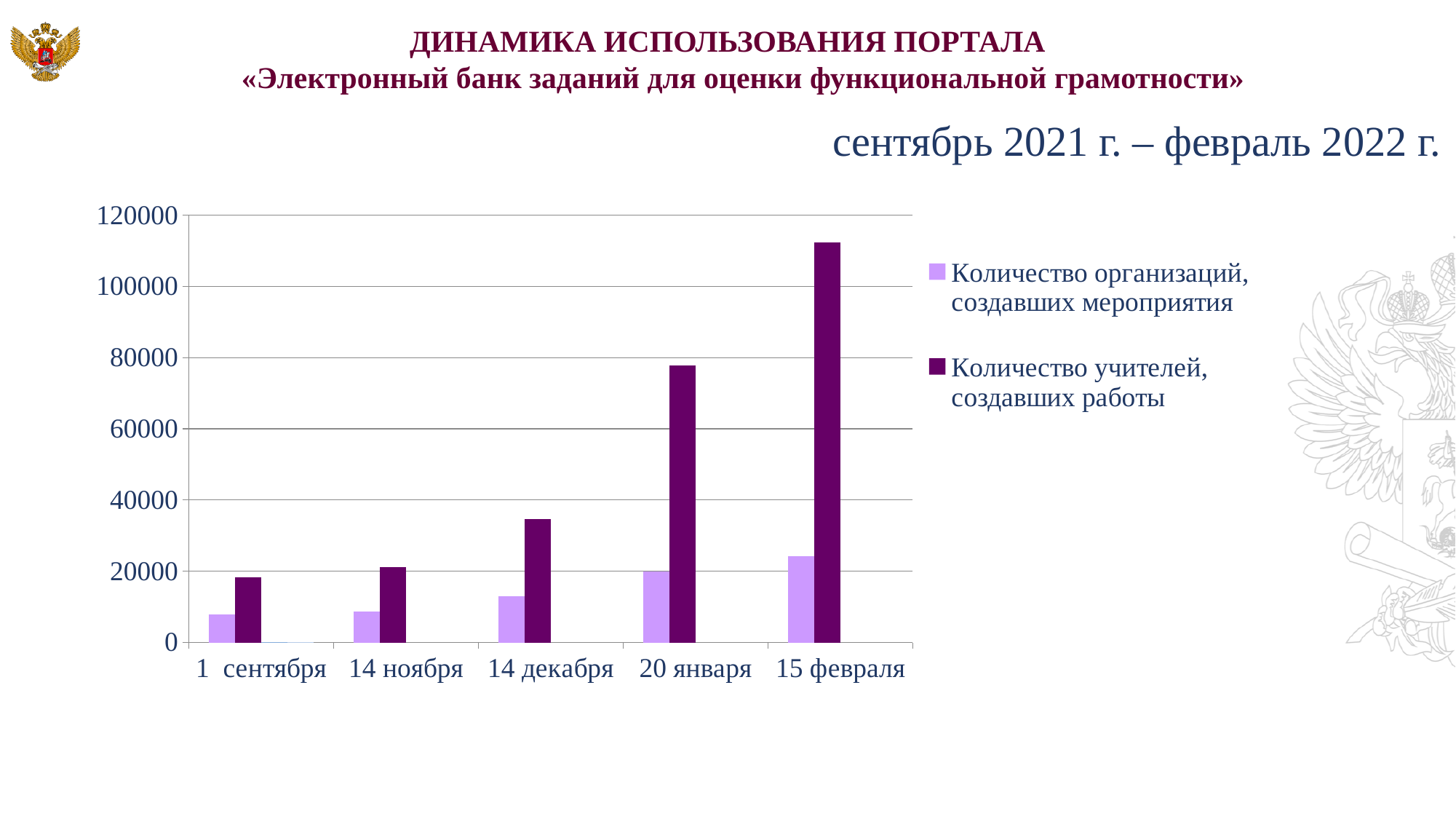
Is the value for «Количество учителей, создавших работы» on 15 февраля greater or less than 100000? greater On which date is the value for «Количество учителей, создавших работы» highest? 15 февраля Is the value for «Количество учителей, создавших работы» on 20 января greater or less than 60000? greater On which date is the value for «Количество организаций, создавших мероприятия» highest? 15 февраля What kind of chart is shown on the slide? bar chart On which date is the value for «Количество учителей, создавших работы» lowest? 1 сентября Do the values for «Количество учителей, создавших работы» rise or fall from 1 сентября to 15 февраля? rise How many dates are shown along the x axis? 5 On 15 февраля, which series has the larger value: «Количество организаций, создавших мероприятия» or «Количество учителей, создавших работы»? Количество учителей, создавших работы Is the value for «Количество учителей, создавших работы» on 14 декабря greater or less than 40000? less How many series does the legend list? 2